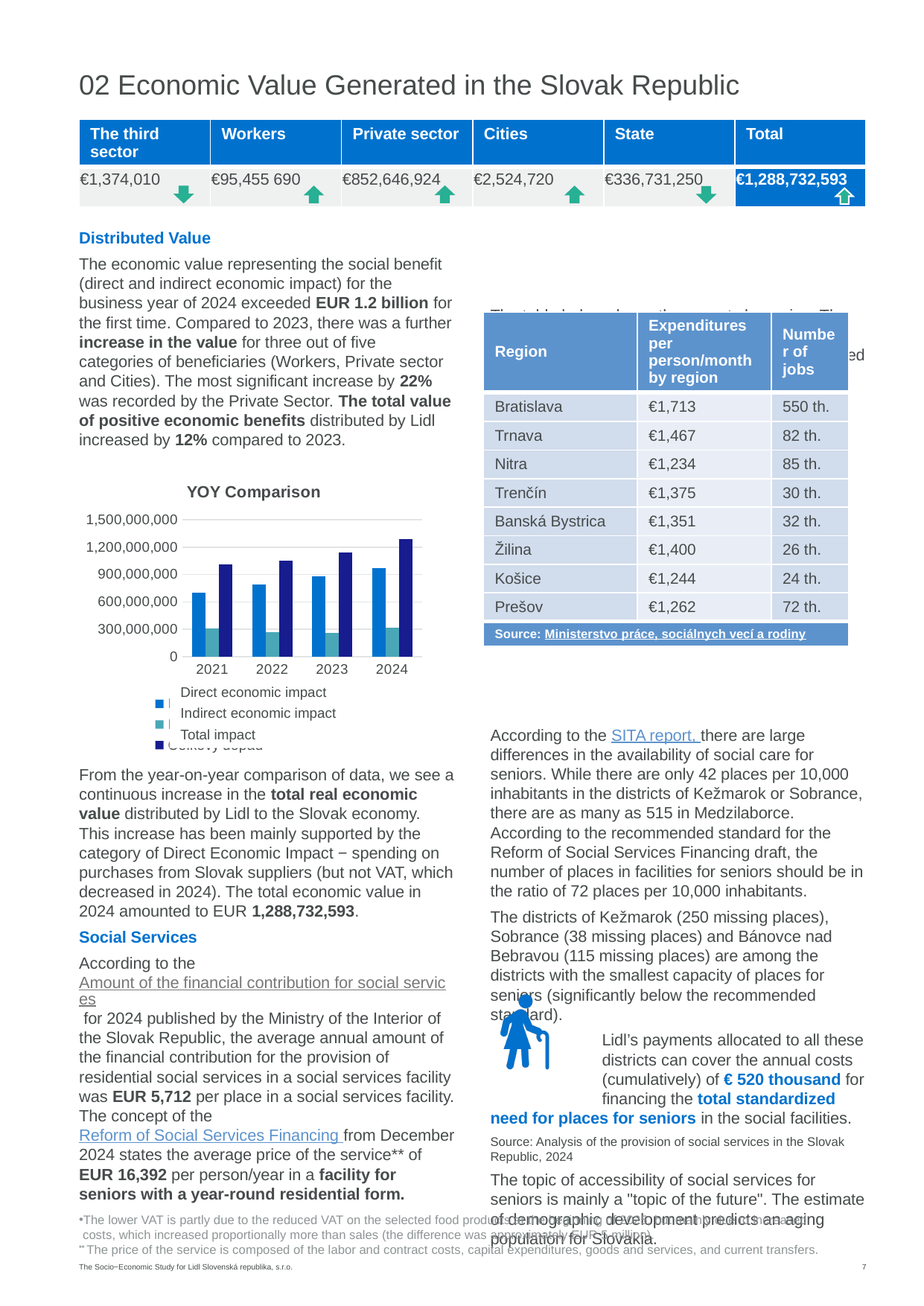
In the YOY Comparison chart, does the Total impact rise or fall from 2021 to 2024? rise In the YOY Comparison chart, which year has the highest Total impact? 2024 In the YOY Comparison chart, is the Direct economic impact for 2024 greater or less than 900,000,000? greater In the YOY Comparison chart, is the Total impact for 2023 greater or less than 1,200,000,000? less What is the title of the bar chart on the slide? YOY Comparison In the YOY Comparison chart, is the Direct economic impact for 2021 greater or less than 600,000,000? greater Which series in the YOY Comparison chart is shown in dark navy blue? Total impact In the YOY Comparison chart, which is larger: the Direct economic impact in 2021 or in 2024? 2024 What type of chart is the YOY Comparison chart? bar chart How many series does the legend of the YOY Comparison chart list? 3 How many years are shown on the x axis of the YOY Comparison chart? 4